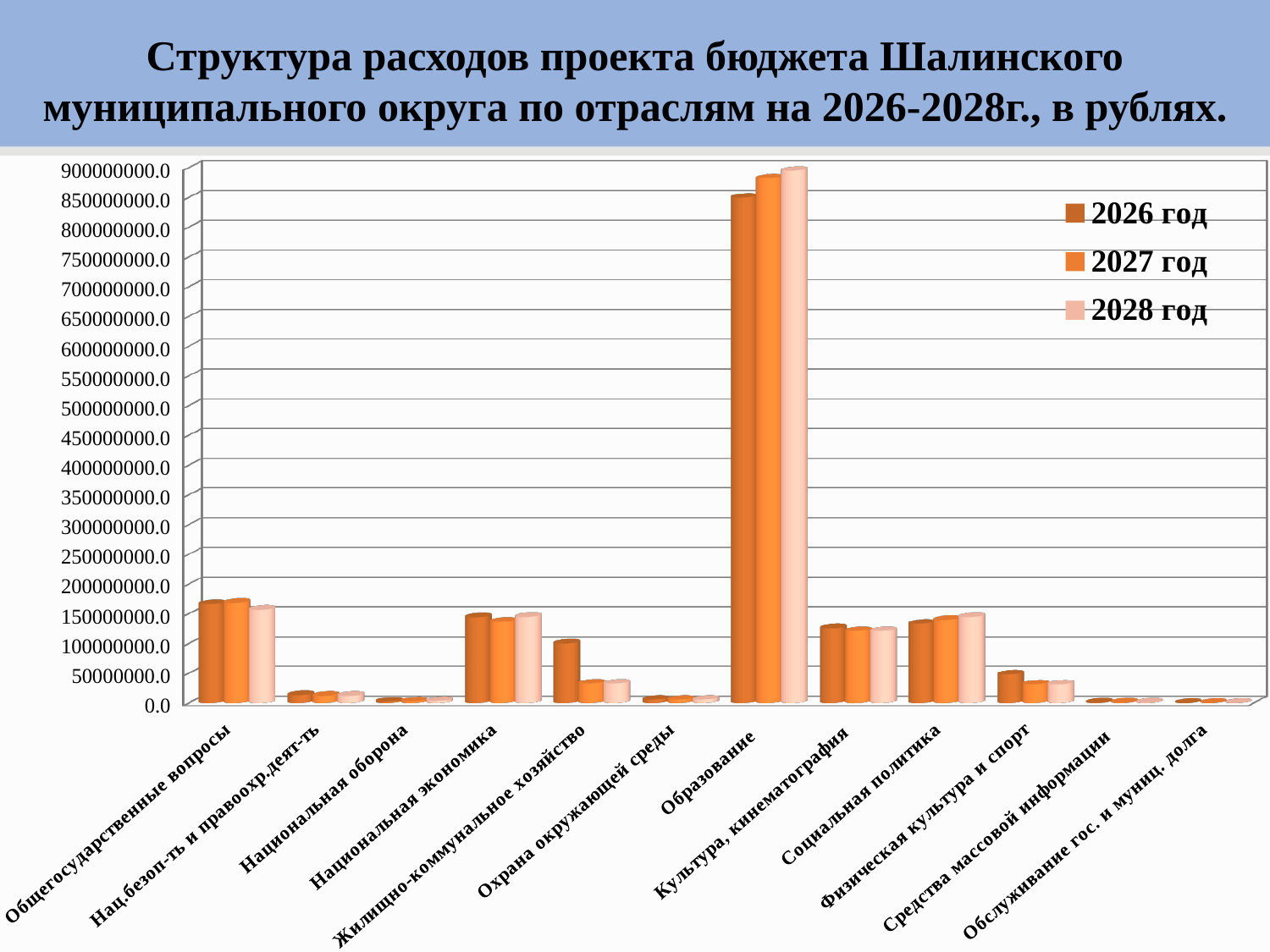
Is the value for Культура, кинематография in 2026 год greater or less than 100000000.0? greater What kind of chart is shown on the slide? bar chart Is the value for Жилищно-коммунальное хозяйство in 2027 год greater or less than 50000000.0? less Which is larger for 2026 год: Жилищно-коммунальное хозяйство or Физическая культура и спорт? Жилищно-коммунальное хозяйство Is the value for Образование in 2026 год greater or less than 800000000.0? greater How many categories are shown along the x axis? 12 How many series does the legend list? 3 For Образование, do the values rise or fall from 2026 год to 2028 год? rise Which category has the highest value for 2026 год? Образование What are the three legend entries of the chart? 2026 год, 2027 год, 2028 год